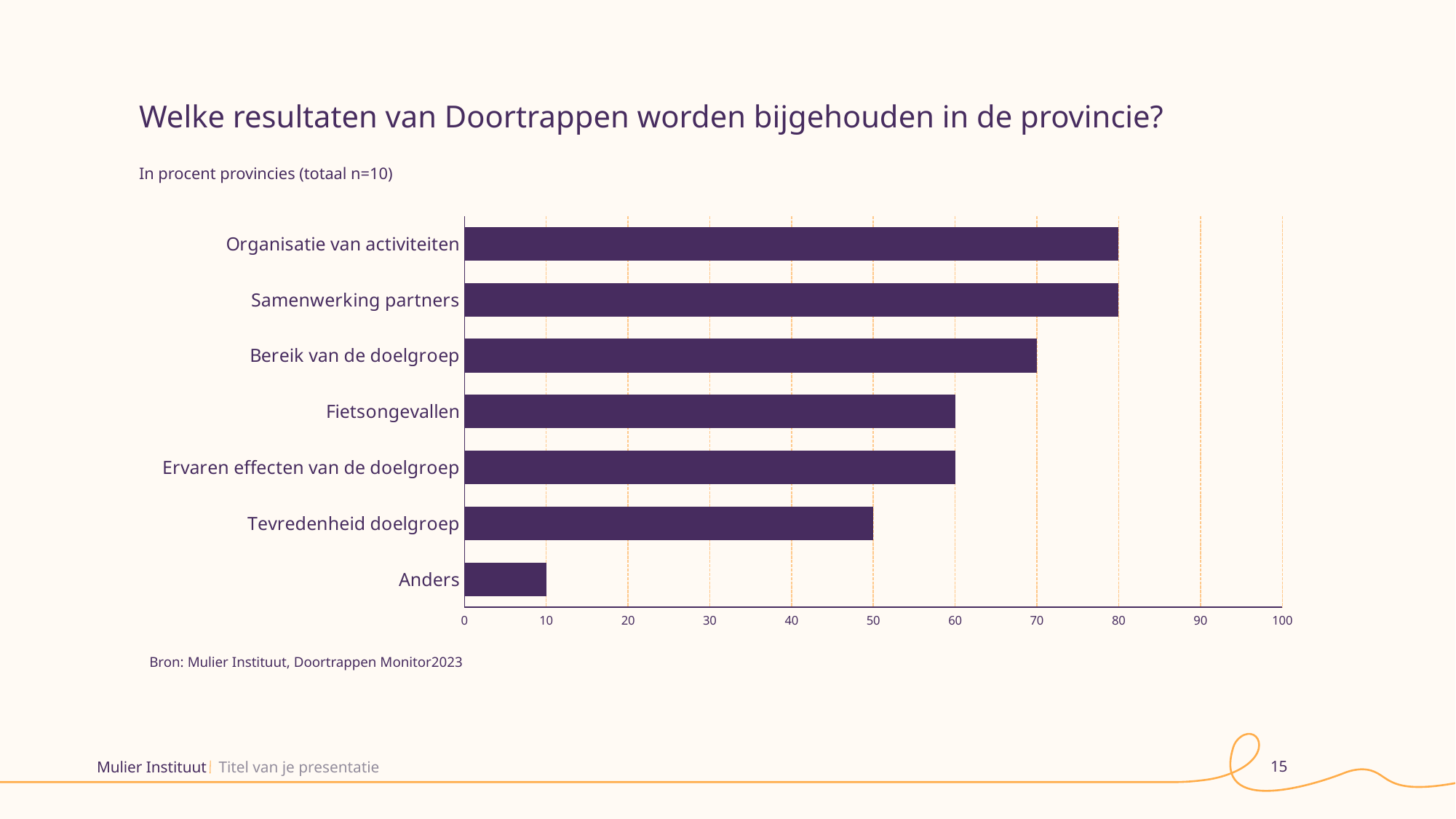
What is the value for Anders? 10 Which is larger, the value for Fietsongevallen or the value for Anders? Fietsongevallen What is the title of the chart on the slide? Welke resultaten van Doortrappen worden bijgehouden in de provincie? What is the difference between the values for Bereik van de doelgroep and Tevredenheid doelgroep? 20 What is the source cited below the chart? Mulier Instituut, Doortrappen Monitor2023 Which category has the lowest value? Anders What kind of chart is shown on the slide? bar chart What is the value for Bereik van de doelgroep? 70 What is the value for Tevredenheid doelgroep? 50 What is the value for Samenwerking partners? 80 How many categories are shown in the chart? 7 Is the value for Ervaren effecten van de doelgroep greater or less than 40? greater